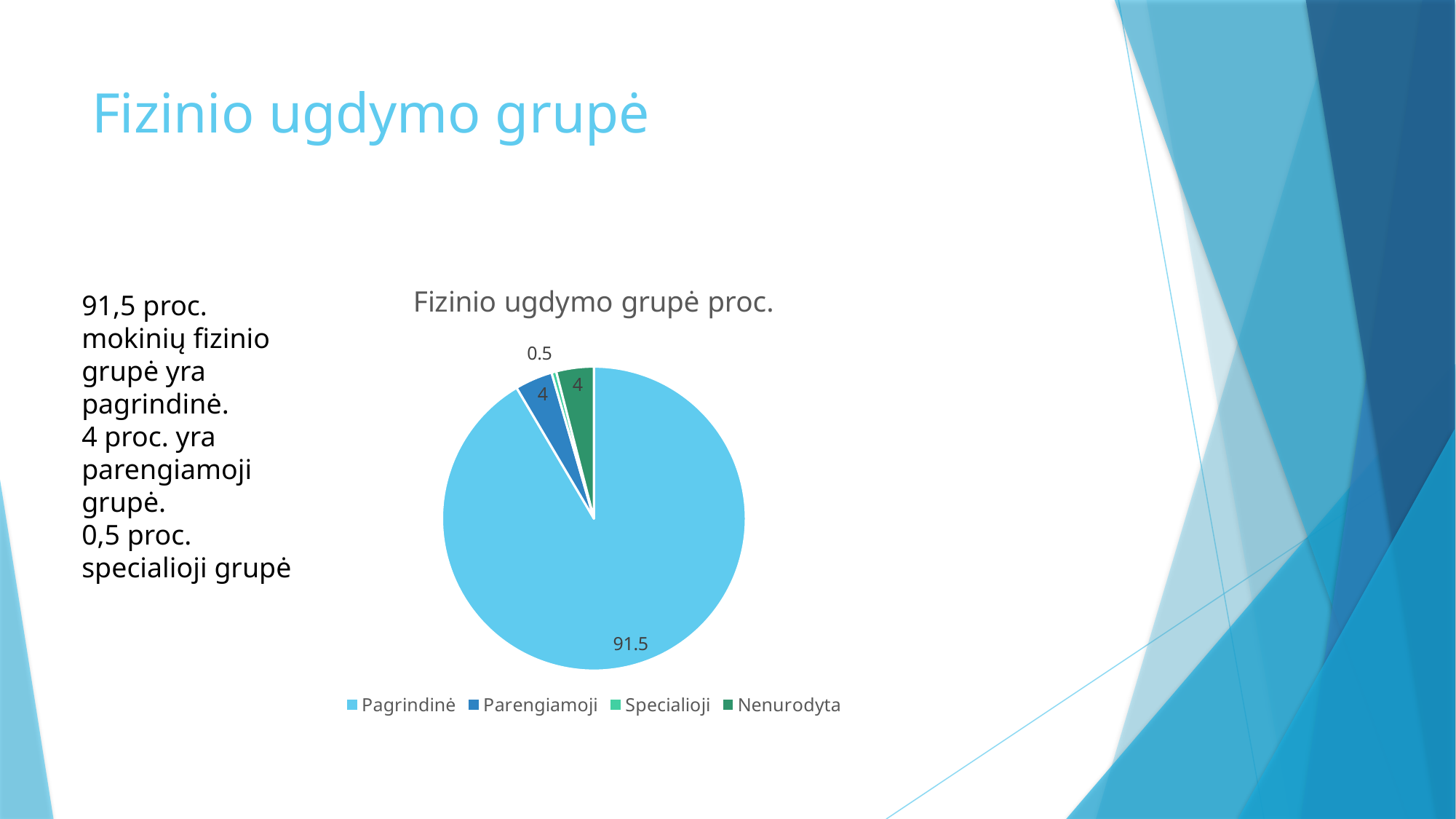
What is the difference between the values for Pagrindinė and Parengiamoji? 87.5 What is the value shown for Nenurodyta? 4 What is the value shown for Pagrindinė? 91.5 Which category has the smallest slice of the pie? Specialioji What kind of chart is shown on the slide? pie chart What is the title of the chart? Fizinio ugdymo grupė proc. Which category has the largest slice of the pie? Pagrindinė What is the value shown for Parengiamoji? 4 Which is larger, the value for Parengiamoji or the value for Specialioji? Parengiamoji How many slices does the pie chart have? 4 How many entries does the chart legend list? 4 What is the value shown for Specialioji? 0.5